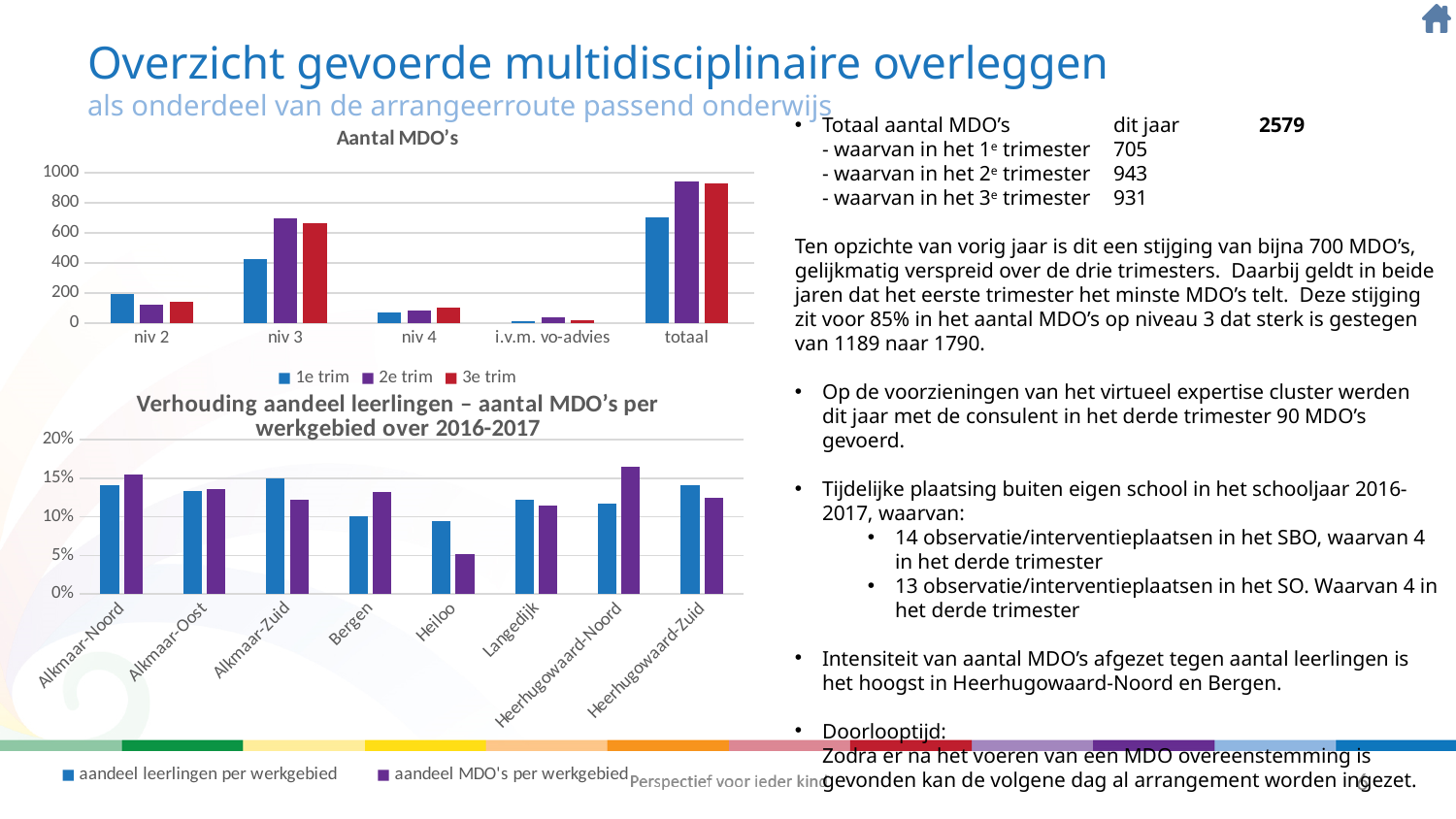
What kind of chart is the 'Aantal MDO's' chart? bar chart How many werkgebieden are shown on the x axis of the 'Verhouding aandeel leerlingen – aantal MDO's per werkgebied over 2016-2017' chart? 8 In the 'Aantal MDO's' chart, for niv 2, which is larger: the 1e trim value or the 2e trim value? 1e trim In the 'Verhouding aandeel leerlingen – aantal MDO's per werkgebied over 2016-2017' chart, is the 'aandeel MDO's per werkgebied' for Heiloo greater or less than 10%? less In the 'Aantal MDO's' chart, excluding 'totaal', which category has the highest 2e trim value? niv 3 In the 'Aantal MDO's' chart, is the 2e trim value for niv 2 greater or less than 200? less In the 'Aantal MDO's' chart, which category has the lowest values across all three trimesters? i.v.m. vo-advies How many categories are shown on the x axis of the 'Aantal MDO's' chart? 5 In the 'Verhouding aandeel leerlingen – aantal MDO's per werkgebied over 2016-2017' chart, which werkgebied has the highest 'aandeel MDO's per werkgebied'? Heerhugowaard-Noord How many series does the legend of the 'Aantal MDO's' chart list? 3 In the 'Aantal MDO's' chart, is the 2e trim value for niv 3 greater or less than 600? greater In the 'Verhouding aandeel leerlingen – aantal MDO's per werkgebied over 2016-2017' chart, for Bergen, which is larger: 'aandeel leerlingen per werkgebied' or 'aandeel MDO's per werkgebied'? aandeel MDO's per werkgebied